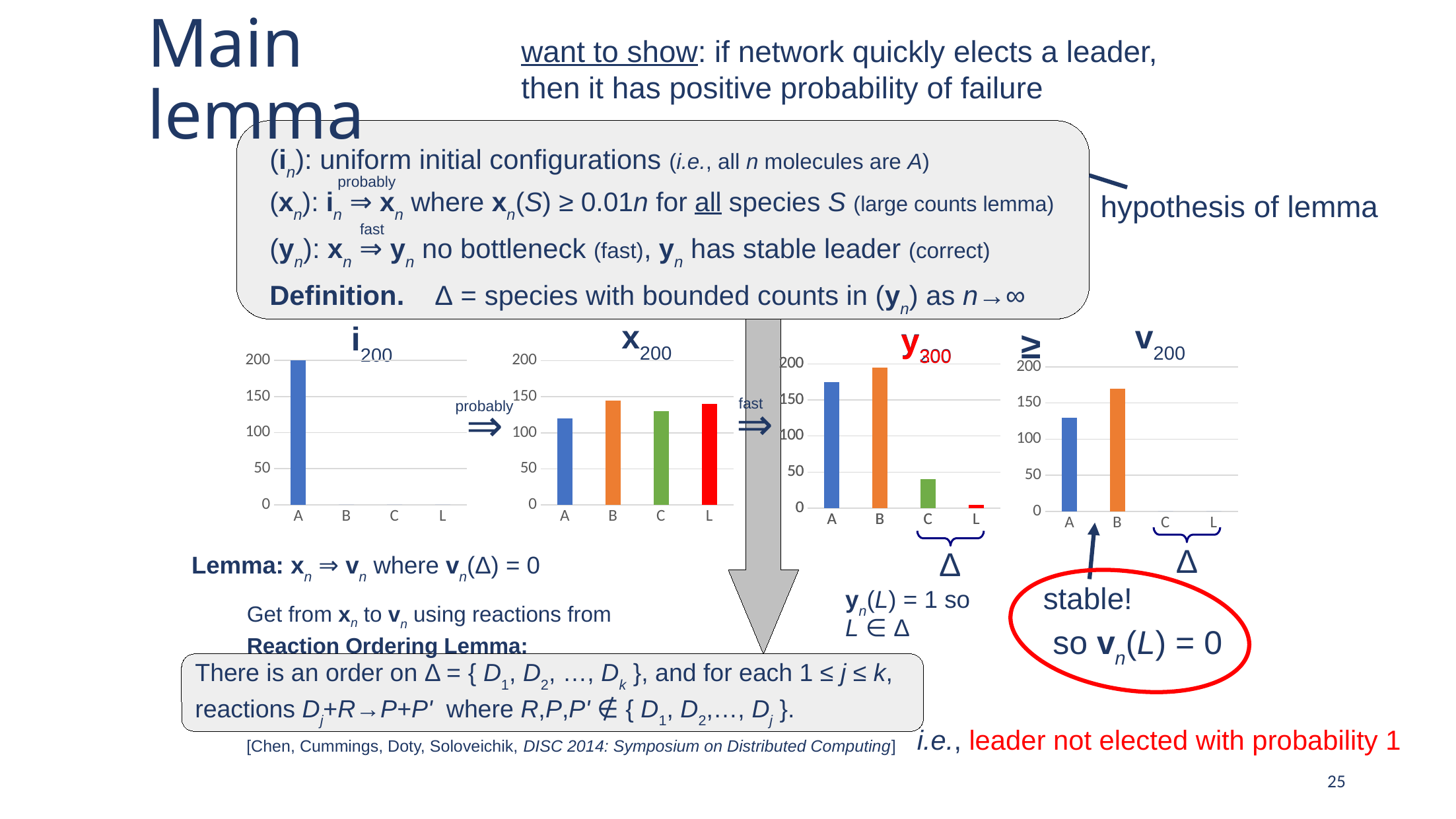
In the chart titled i200, what is the value for A? 200 In the chart titled y200, which category has the highest value? B How many bar charts are shown on the slide? 4 What kind of chart is the chart titled i200? bar chart In the chart titled y200, which category has the lowest value? L In the chart titled v200, which is larger, the value for A or the value for B? B In the chart titled y200, is the value for C greater or less than 50? less In the chart titled x200, is the value for C greater or less than 100? greater In the chart titled v200, is the value for A greater or less than 100? greater In the chart titled x200, which category has the highest value? B How many categories are shown on the x axis of the chart titled x200? 4 In the chart titled x200, which category has the lowest value? A